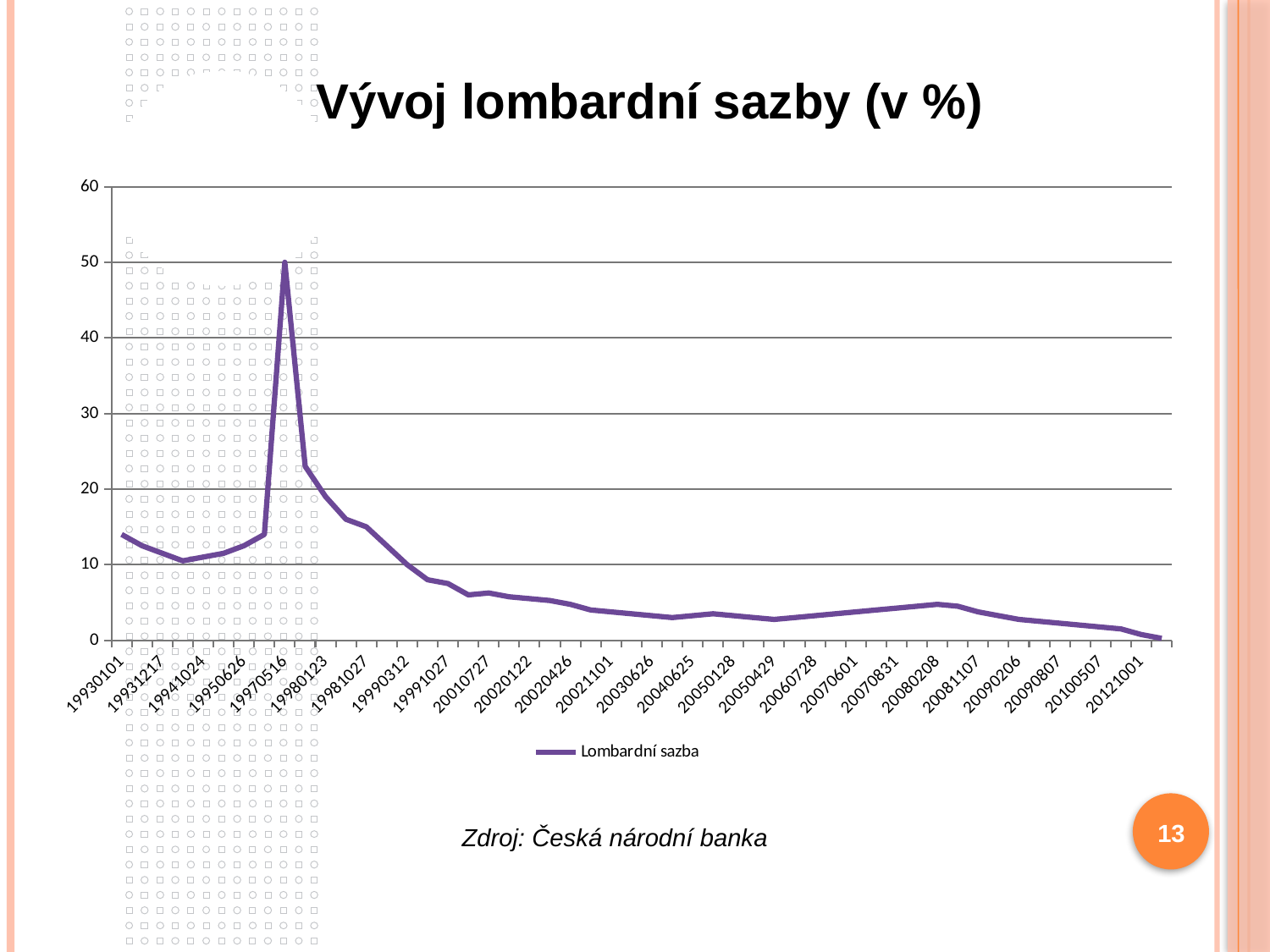
What is the name of the series shown in the legend? Lombardní sazba From 19980123 to 20121001, do the values generally rise or fall? fall How many series does the legend list? 1 Is the value for 19970516 greater or less than 40? greater Is the value for 19930101 greater or less than 10? greater At which date on the x axis does the Lombardní sazba reach its highest value? 19970516 Which has the larger value, 19980123 or 19981027? 19980123 Is the value for 19941024 greater or less than 20? less What kind of chart is shown on the slide? line chart What is the title of the chart? Vývoj lombardní sazby (v %)